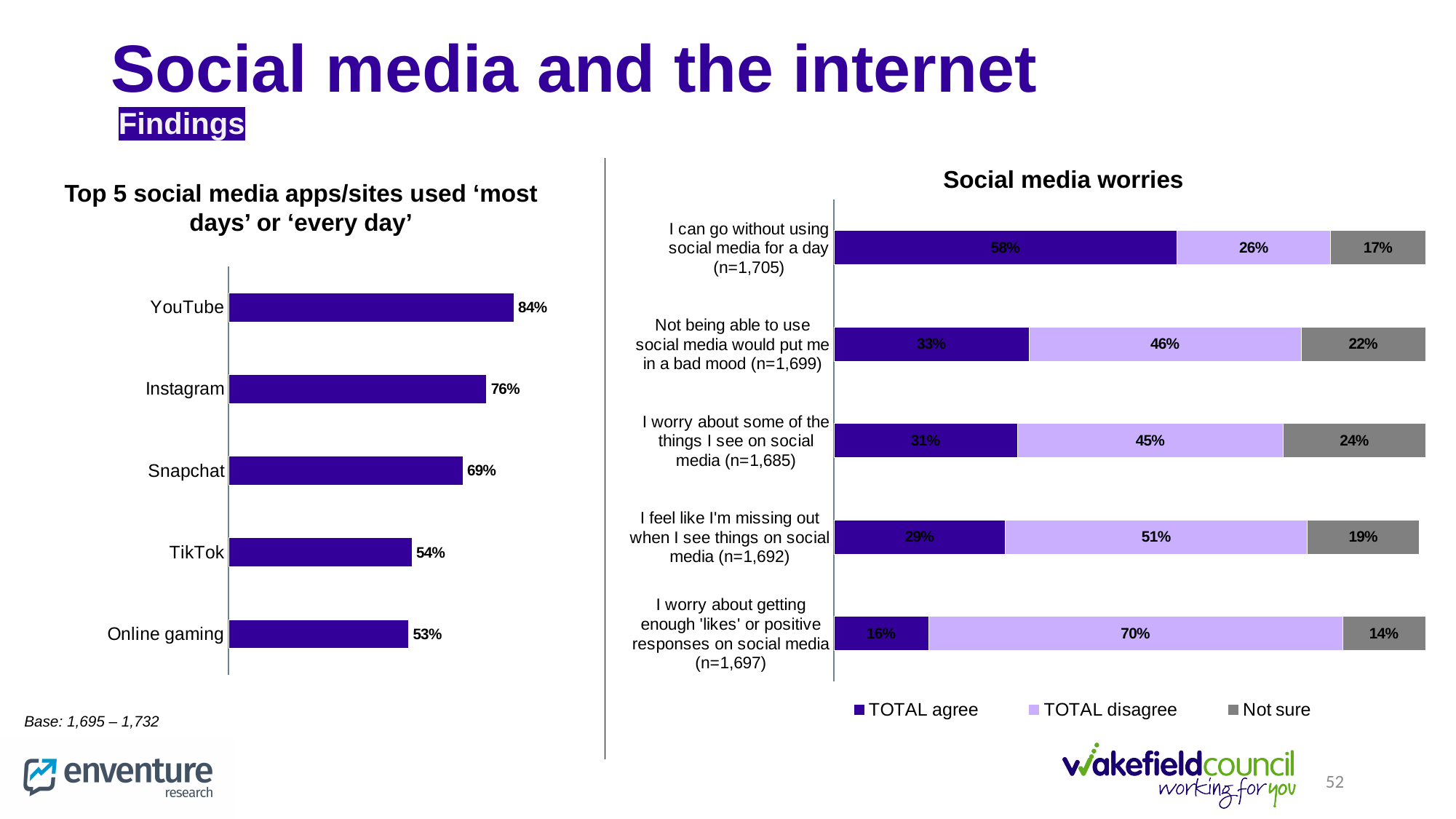
In the 'Top 5 social media apps/sites' chart, which app/site has the lowest value? Online gaming In the 'Top 5 social media apps/sites' chart, which app/site has the highest value? YouTube In the 'Social media worries' chart, which is larger: the 'TOTAL agree' value for 'Not being able to use social media would put me in a bad mood' or for 'I feel like I'm missing out when I see things on social media'? Not being able to use social media would put me in a bad mood In the 'Social media worries' chart, which statement has the highest 'TOTAL disagree' value? I worry about getting enough 'likes' or positive responses on social media In the 'Social media worries' chart, what is the 'Not sure' value for 'I worry about some of the things I see on social media'? 24% What kind of chart is the 'Top 5 social media apps/sites' chart? Bar chart In the 'Social media worries' chart, what is the difference between the 'TOTAL disagree' and 'TOTAL agree' values for 'I worry about getting enough 'likes' or positive responses on social media'? 54% In the 'Social media worries' chart, what percentage of respondents agree that they can go without using social media for a day? 58% In the 'Top 5 social media apps/sites' chart, how many apps/sites are shown? 5 In the 'Top 5 social media apps/sites' chart, what is the value for Instagram? 76% In the 'Top 5 social media apps/sites' chart, what is the difference between the values for YouTube and Snapchat? 15% How many series does the legend of the 'Social media worries' chart list? 3